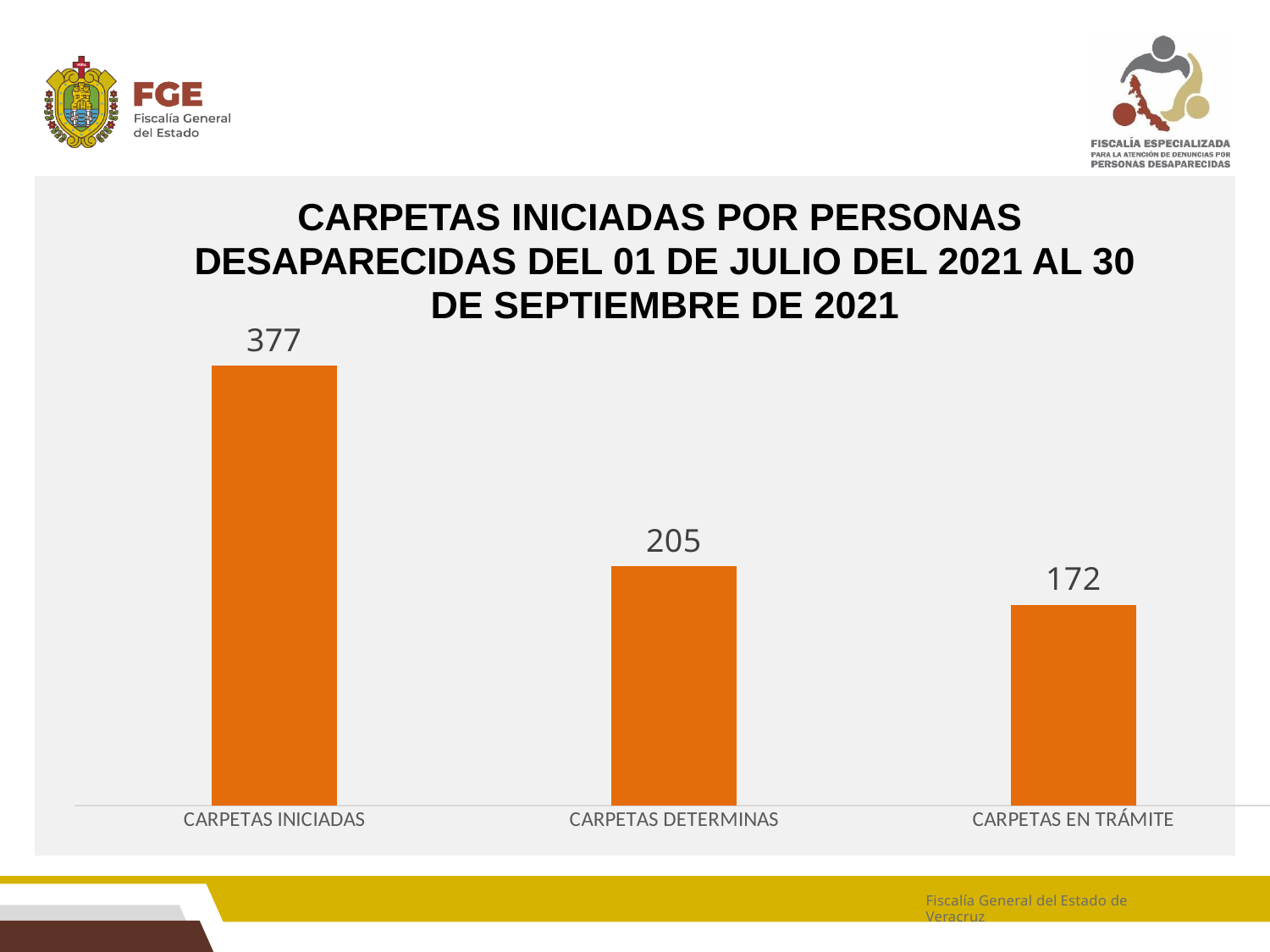
What is the value for CARPETAS INICIADAS? 377 What is the value for CARPETAS DETERMINAS? 205 How many categories are shown in the chart? 3 Which category has the highest value? CARPETAS INICIADAS Which category has the lowest value? CARPETAS EN TRÁMITE What kind of chart is shown on the slide? Bar chart What is the difference between CARPETAS DETERMINAS and CARPETAS EN TRÁMITE? 33 What is the difference between CARPETAS INICIADAS and CARPETAS DETERMINAS? 172 Do the values rise or fall from left to right across the categories? Fall Which is larger, CARPETAS DETERMINAS or CARPETAS EN TRÁMITE? CARPETAS DETERMINAS What is the value for CARPETAS EN TRÁMITE? 172 What colour are the bars in the chart? Orange